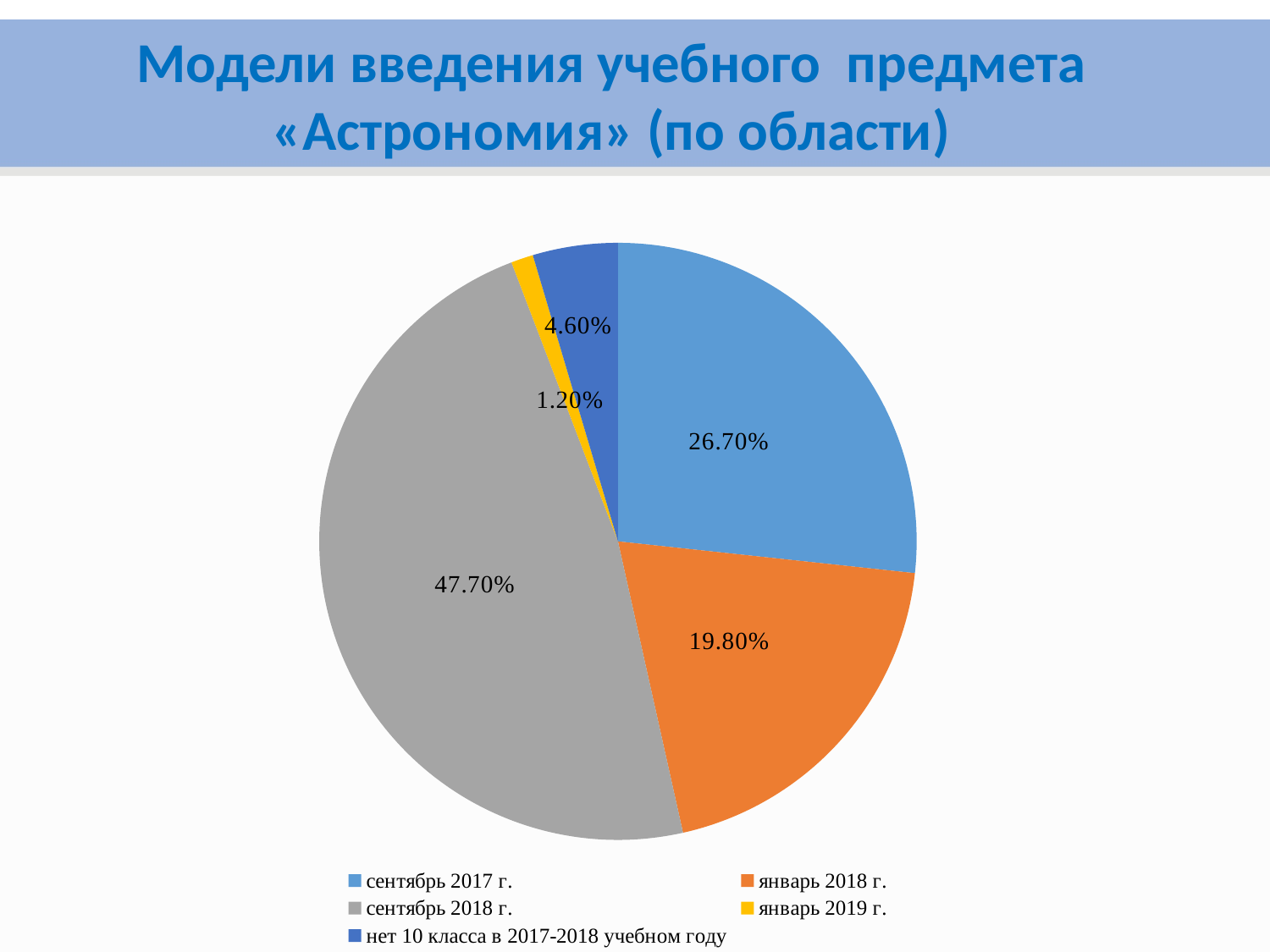
What is the value for январь 2019 г.? 1.20% Which category has the largest slice? сентябрь 2018 г. What is the difference between the values for сентябрь 2018 г. and сентябрь 2017 г.? 21.00% What colour is the slice for сентябрь 2018 г.? grey How many categories does the legend list? 5 Which category has the smallest slice? январь 2019 г. What is the value for сентябрь 2017 г.? 26.70% What is the value for нет 10 класса в 2017-2018 учебном году? 4.60% What is the value for сентябрь 2018 г.? 47.70% Which is larger, the value for сентябрь 2017 г. or январь 2018 г.? сентябрь 2017 г. What is the value for январь 2018 г.? 19.80% What kind of chart is shown on the slide? pie chart